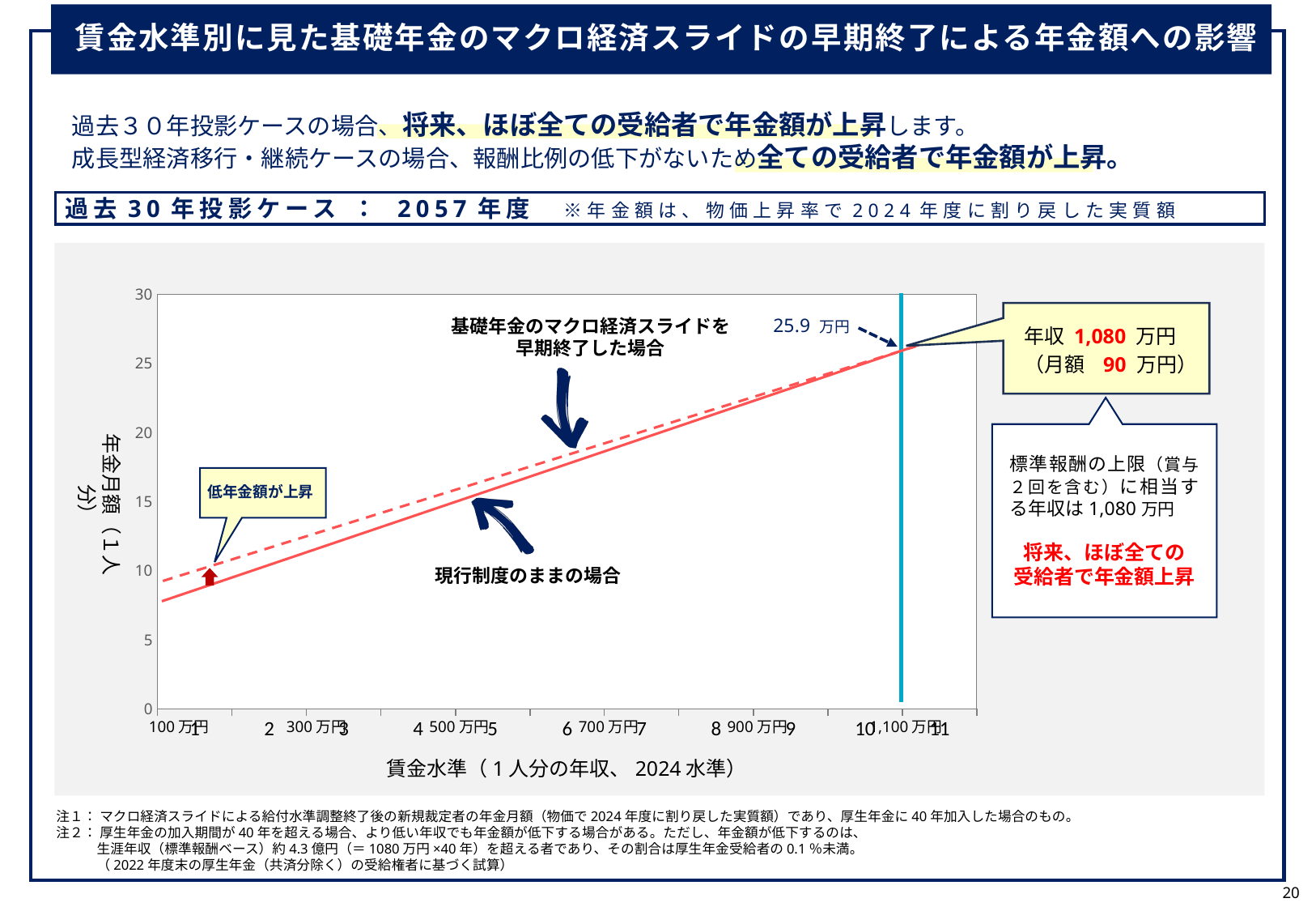
Is the value of the 現行制度のままの場合 line at a wage level of 300 万円 greater or less than 15? less What is the maximum value shown on the y axis of the chart? 30 What kind of chart is shown on the slide? line chart At what annual income (年収) does the vertical line on the chart sit, according to the callout? 1,080 万円 What monthly amount (月額) corresponds to the annual income of 1,080 万円 in the callout? 90 万円 Is the value of the 現行制度のままの場合 line at a wage level of 100 万円 greater or less than 10? less What pension monthly amount is labelled at the point where the two lines meet? 25.9 万円 What is the x-axis title of the chart? 賃金水準（1人分の年収、2024水準） Do the pension amounts rise or fall as the wage level increases along the x axis? rise How many lines are plotted on the chart? 2 At a wage level of 500 万円, which line is higher: 基礎年金のマクロ経済スライドを早期終了した場合 (dashed) or 現行制度のままの場合 (solid)? 基礎年金のマクロ経済スライドを早期終了した場合 (dashed) Is the value of the 基礎年金のマクロ経済スライドを早期終了した場合 line at a wage level of 900 万円 greater or less than 20? greater